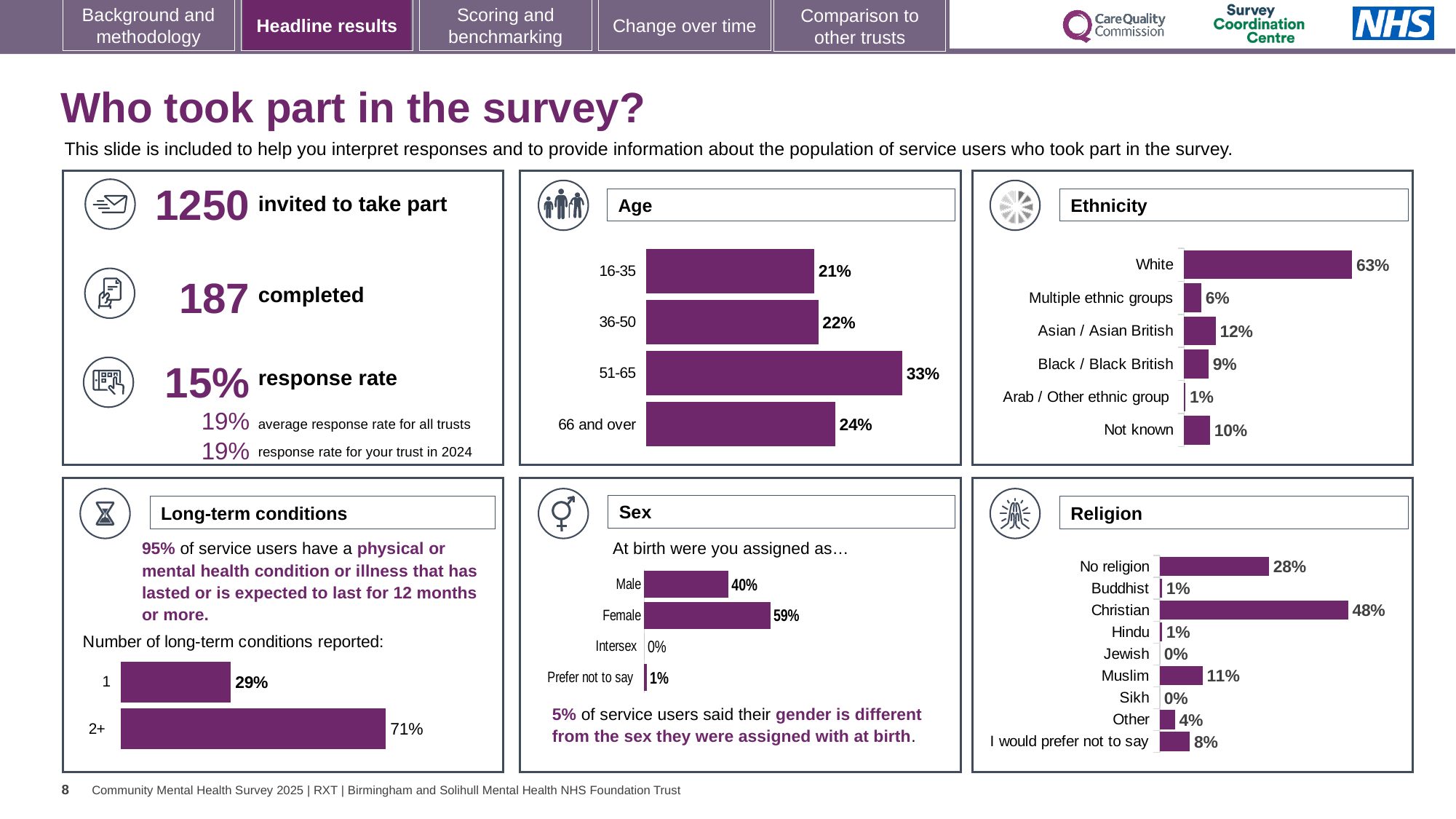
In the Long-term conditions chart, what percentage reported 2+ conditions? 71% In the Religion chart, what is the value for Muslim? 11% In the Religion chart, what is the difference between Christian and No religion? 20% In the Age chart, what percentage of respondents were aged 51-65? 33% In the Ethnicity chart, which category has the highest percentage? White In the Sex chart, which is larger, Male or Female? Female What type of chart is used in the Age panel? Bar chart In the Ethnicity chart, what is the difference between White and Not known? 53% In the Religion chart, how many categories are shown? 9 In the Sex chart, what percentage answered Prefer not to say? 1% In the Ethnicity chart, what is the value for Asian / Asian British? 12% In the Age chart, which age group has the lowest percentage? 16-35